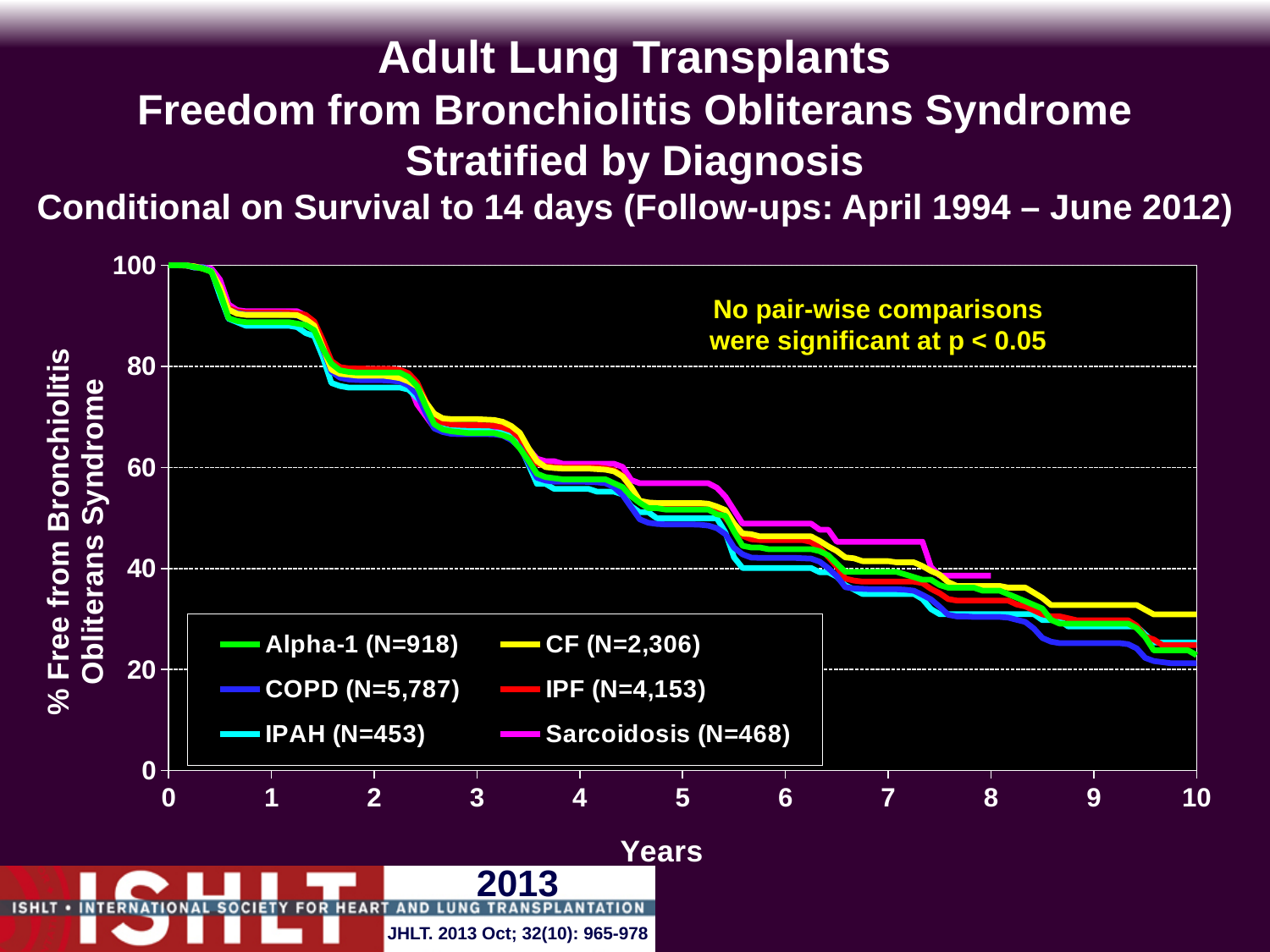
Is the value for Sarcoidosis at year 5 greater or less than 40? greater Is the value for IPAH at year 2 greater or less than 80? less At year 7, which is higher: Sarcoidosis or COPD? Sarcoidosis How many series does the legend list? 6 Is the value for COPD at year 10 greater or less than 40? less According to the legend, what is the N for the COPD group? N=5,787 How many tick marks are labelled on the Years axis? 11 What kind of chart is shown on the slide? Line chart Which diagnosis group has the highest % free from Bronchiolitis Obliterans Syndrome at year 10? CF Do the curves rise or fall as the years increase along the x axis? Fall What does the annotation inside the chart say about pair-wise comparisons? No pair-wise comparisons were significant at p < 0.05